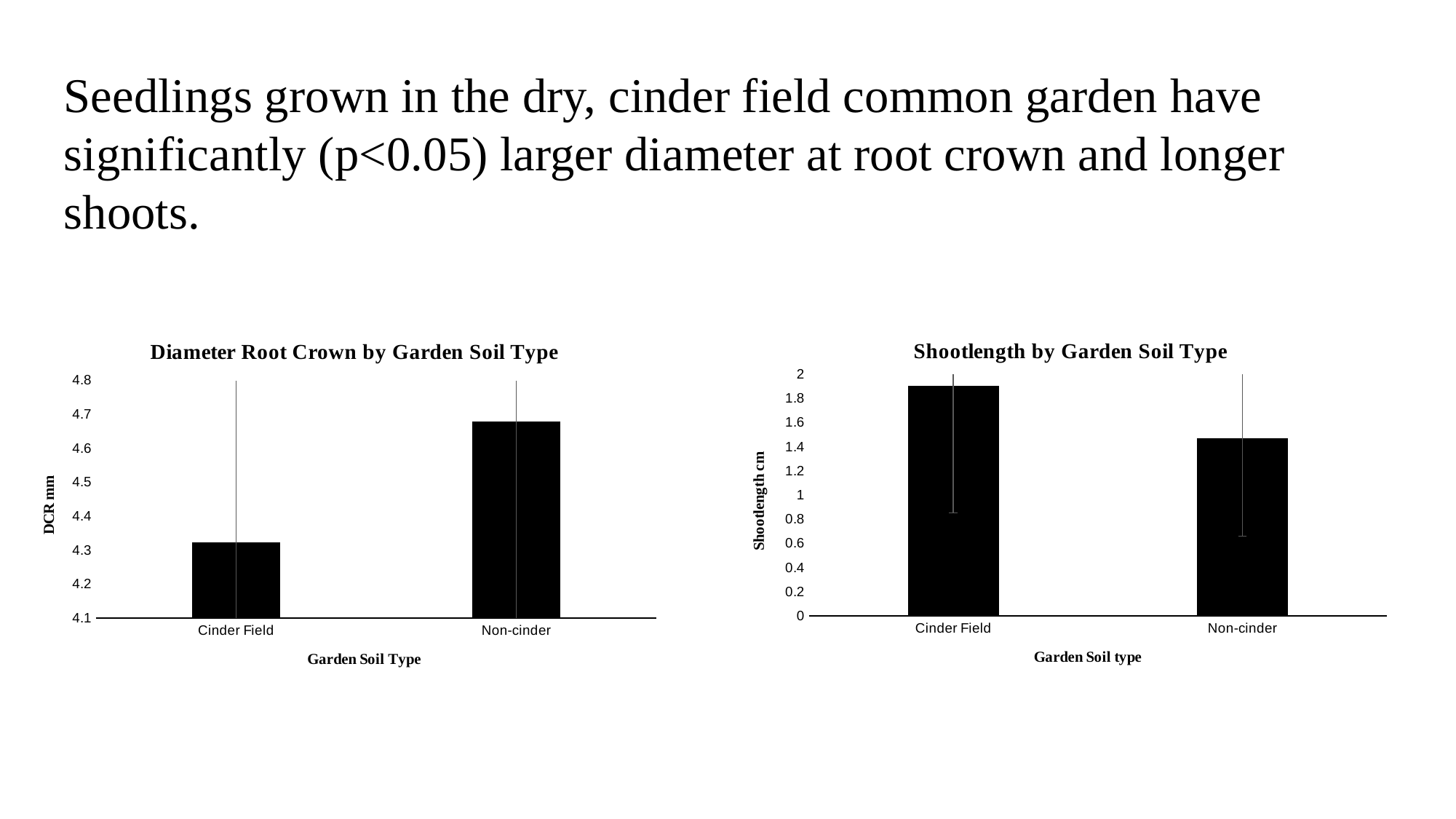
In the 'Diameter Root Crown by Garden Soil Type' chart, what is the y-axis label? DCR mm In the 'Shootlength by Garden Soil Type' chart, is the value for Non-cinder greater or less than 1.6? less In the 'Shootlength by Garden Soil Type' chart, what is the y-axis label? Shootlength cm In the 'Diameter Root Crown by Garden Soil Type' chart, is the value for Cinder Field greater or less than 4.4? less In the 'Diameter Root Crown by Garden Soil Type' chart, is the value for Non-cinder greater or less than 4.6? greater In the 'Diameter Root Crown by Garden Soil Type' chart, what kind of chart is shown? bar chart In the 'Diameter Root Crown by Garden Soil Type' chart, how many garden soil type categories are plotted? 2 In the 'Diameter Root Crown by Garden Soil Type' chart, which garden soil type has the higher bar? Non-cinder In the 'Shootlength by Garden Soil Type' chart, which garden soil type has the higher bar? Cinder Field In the 'Diameter Root Crown by Garden Soil Type' chart, which garden soil type has the lower bar? Cinder Field In the 'Shootlength by Garden Soil Type' chart, which garden soil type has the lower bar? Non-cinder